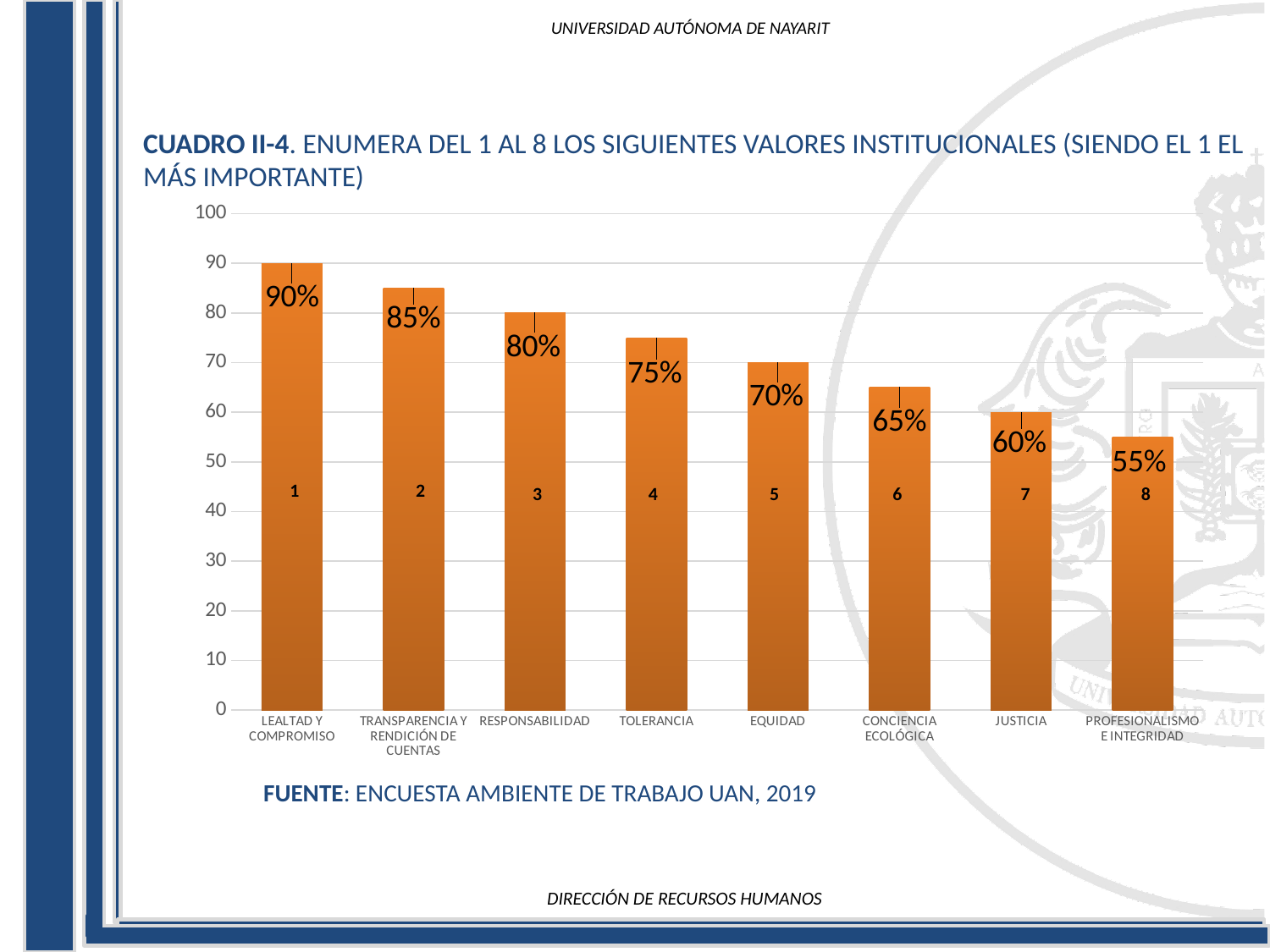
Do the values rise or fall from left to right along the x axis? Fall What is the value for LEALTAD Y COMPROMISO? 90% What is the difference between the values for RESPONSABILIDAD and EQUIDAD? 10% What kind of chart is shown on the slide? Bar chart Which is larger, the value for TRANSPARENCIA Y RENDICIÓN DE CUENTAS or the value for CONCIENCIA ECOLÓGICA? TRANSPARENCIA Y RENDICIÓN DE CUENTAS Which category has the lowest value? PROFESIONALISMO E INTEGRIDAD What is the value for TOLERANCIA? 75% What source is cited below the chart? ENCUESTA AMBIENTE DE TRABAJO UAN, 2019 What is the difference between the values for LEALTAD Y COMPROMISO and PROFESIONALISMO E INTEGRIDAD? 35% How many categories are shown in the chart? 8 What is the value for JUSTICIA? 60% Which category has the highest value? LEALTAD Y COMPROMISO